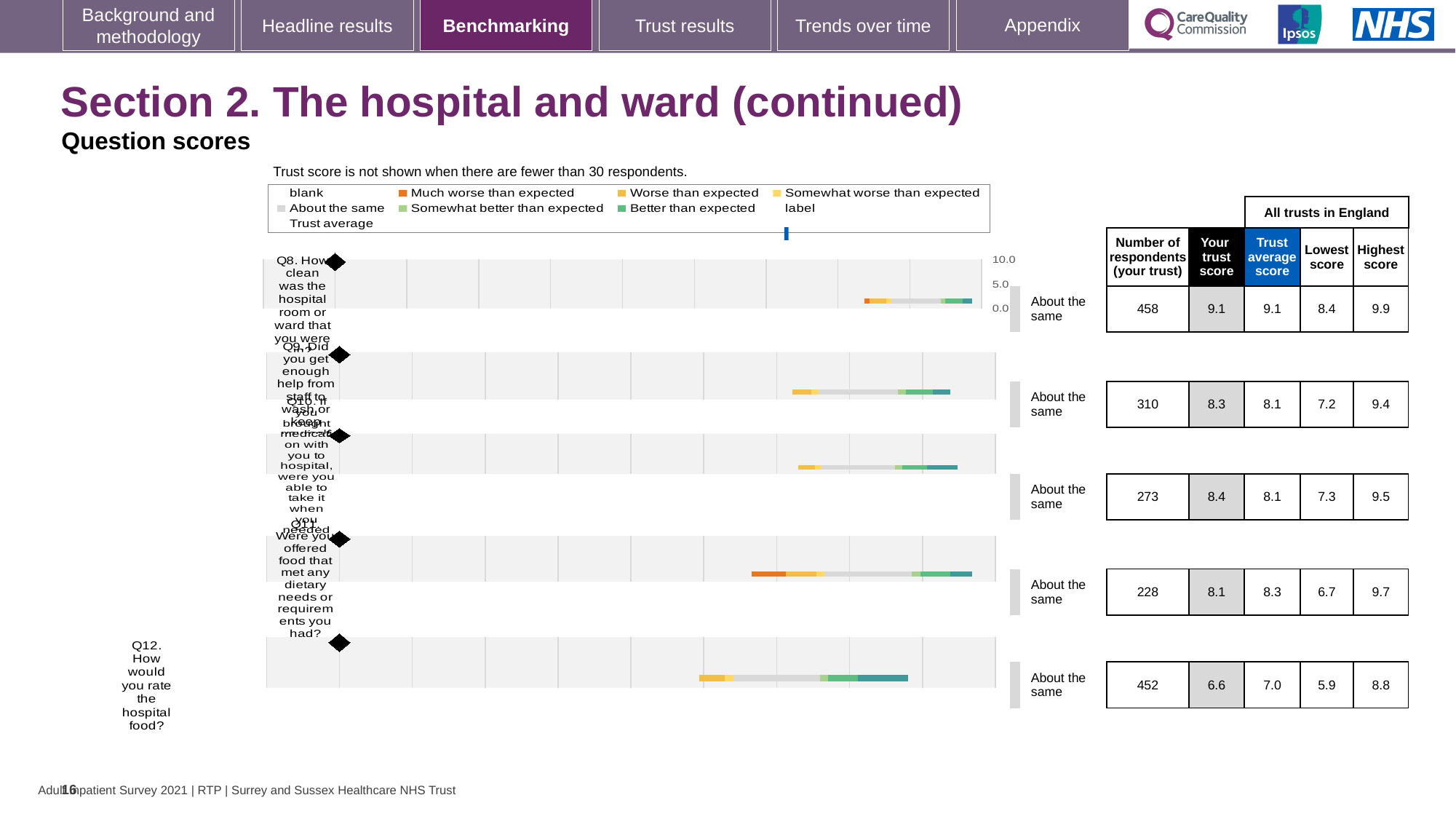
What is the lowest score across all trusts in England for Q9? 7.2 What is the highest score across all trusts in England for Q11? 9.7 Which question has the highest 'Your trust score'? Q8 For Q11, which is larger: the 'Your trust score' or the 'Trust average score'? Trust average score Which question has the lowest 'Your trust score'? Q12 What is the 'Your trust score' for Q8 (how clean was the hospital room or ward)? 9.1 What kind of chart is used to show the question scores on this slide? bar chart What benchmark category is shown for Q10 next to the chart? About the same How many more respondents does Q8 have than Q9 for your trust? 148 How many respondents (your trust) are shown for Q12 (how would you rate the hospital food)? 452 How many questions (categories) are plotted in the question scores chart? 5 For Q12, what is the difference between the highest score and the lowest score across all trusts in England? 2.9